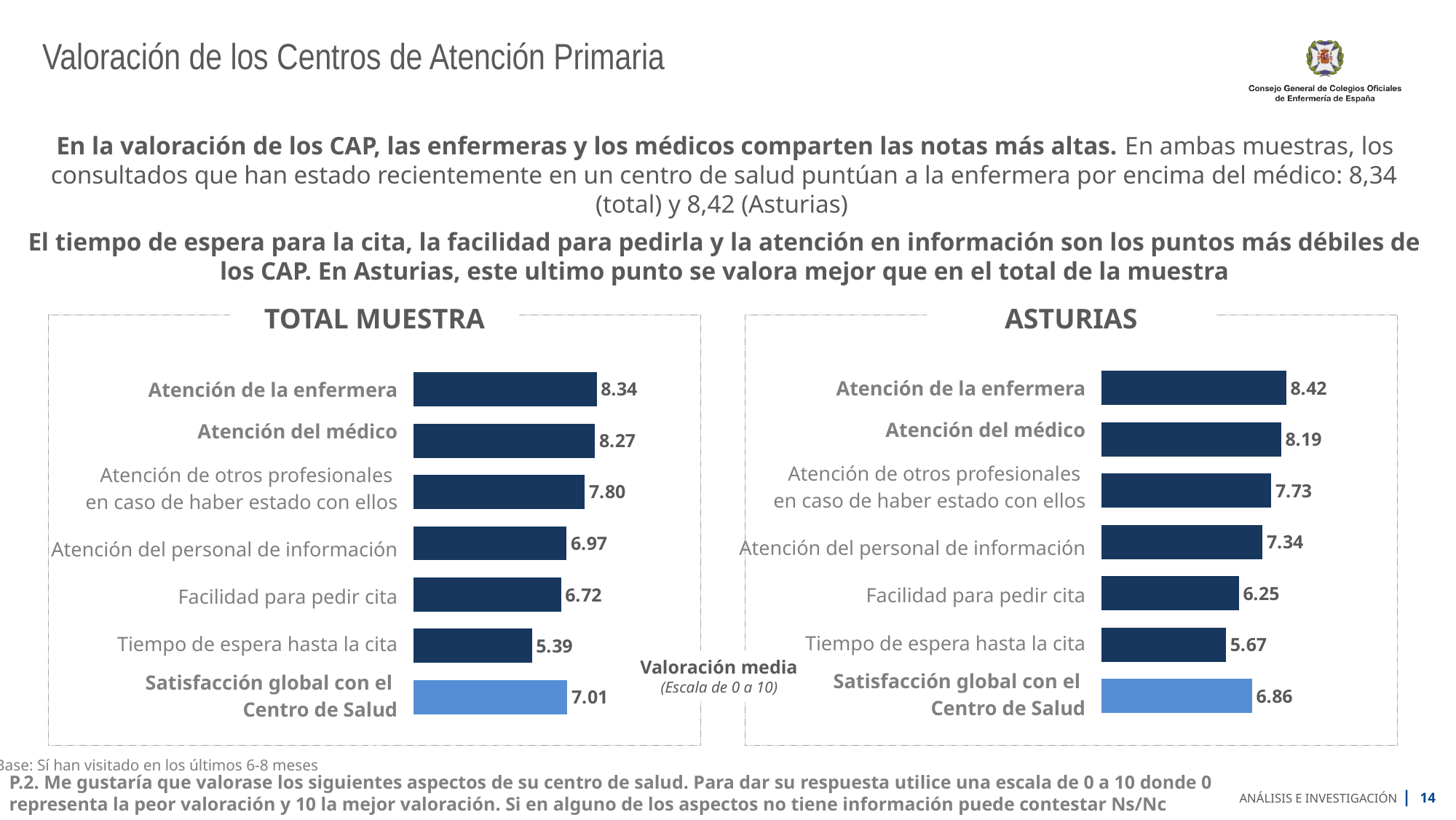
Which is larger: Satisfacción global con el Centro de Salud in the TOTAL MUESTRA chart or in the ASTURIAS chart? TOTAL MUESTRA In the TOTAL MUESTRA chart, what is the value for Atención de la enfermera? 8.34 What kind of chart is the ASTURIAS chart? Bar chart In the ASTURIAS chart, which is larger: Atención del personal de información or Facilidad para pedir cita? Atención del personal de información How many categories are shown in the TOTAL MUESTRA chart? 7 In the ASTURIAS chart, what is the difference between Atención del personal de información and Facilidad para pedir cita? 1.09 In the TOTAL MUESTRA chart, which category has the highest value? Atención de la enfermera In the ASTURIAS chart, which category has the lowest value? Tiempo de espera hasta la cita In the TOTAL MUESTRA chart, which bar is shown in a lighter blue colour than the others? Satisfacción global con el Centro de Salud In the TOTAL MUESTRA chart, what is the difference between Atención de la enfermera and Atención del médico? 0.07 In the ASTURIAS chart, what is the value for Satisfacción global con el Centro de Salud? 6.86 In the ASTURIAS chart, what is the value for Tiempo de espera hasta la cita? 5.67